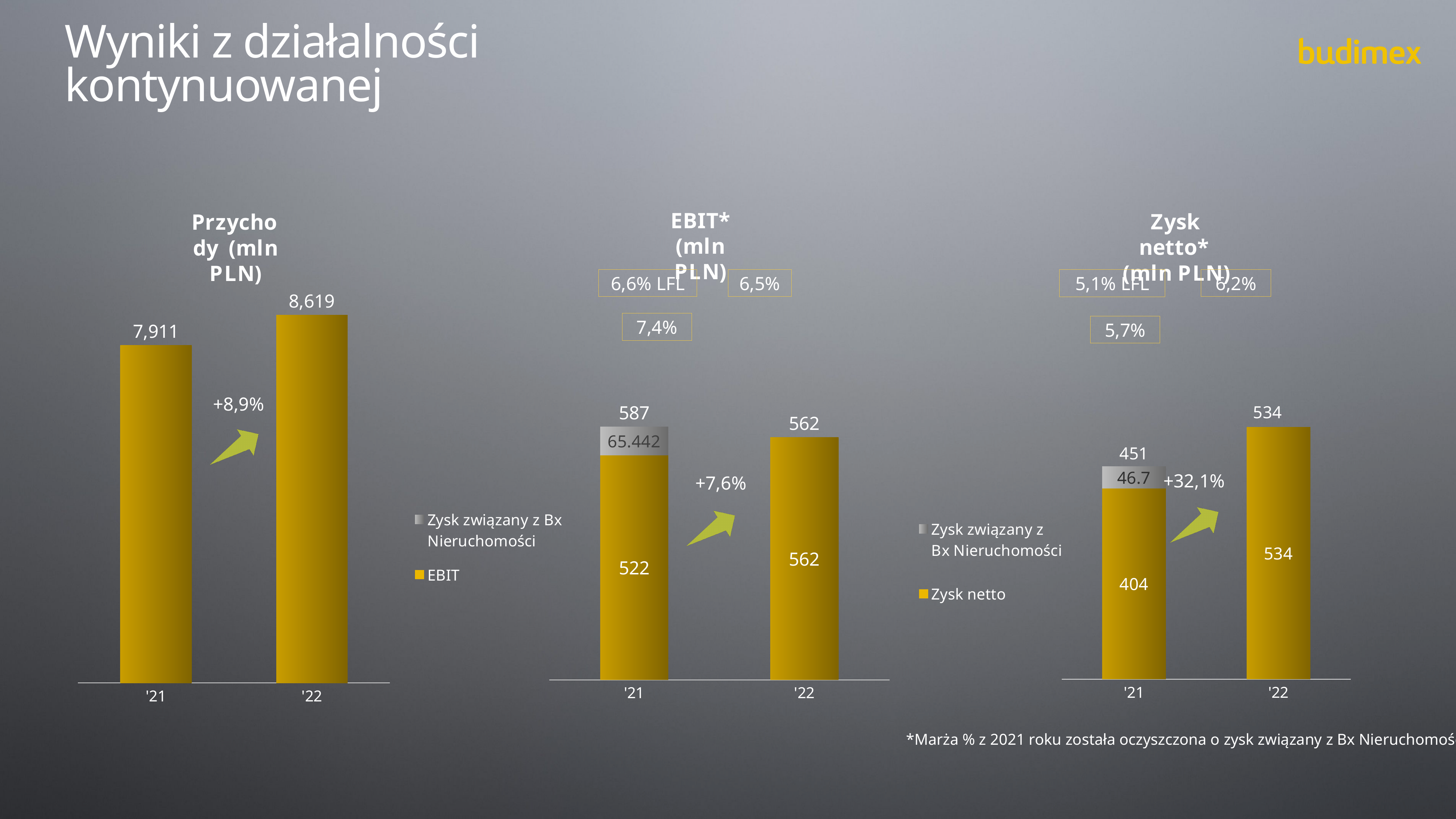
In the EBIT* (mln PLN) chart, what is the value of Zysk związany z Bx Nieruchomości for '21? 65.442 In the Przychody (mln PLN) chart, which year has the higher value? '22 What type of chart is the Zysk netto* (mln PLN) chart? Bar chart In the EBIT* (mln PLN) chart, what is the value for '22? 562 In the Przychody (mln PLN) chart, what is the value for '21? 7,911 In the Zysk netto* (mln PLN) chart, what is the Zysk netto value for '21? 404 In the EBIT* (mln PLN) chart, what is the total of the stacked bar for '21? 587 In the Zysk netto* (mln PLN) chart, what is the difference between the '22 value and the '21 Zysk netto value? 130 In the EBIT* (mln PLN) chart, what is the EBIT value for '21? 522 In the Przychody (mln PLN) chart, what percentage change is shown between '21 and '22? +8,9% How many series does the legend of the EBIT* (mln PLN) chart list? 2 In the Przychody (mln PLN) chart, what is the value for '22? 8,619